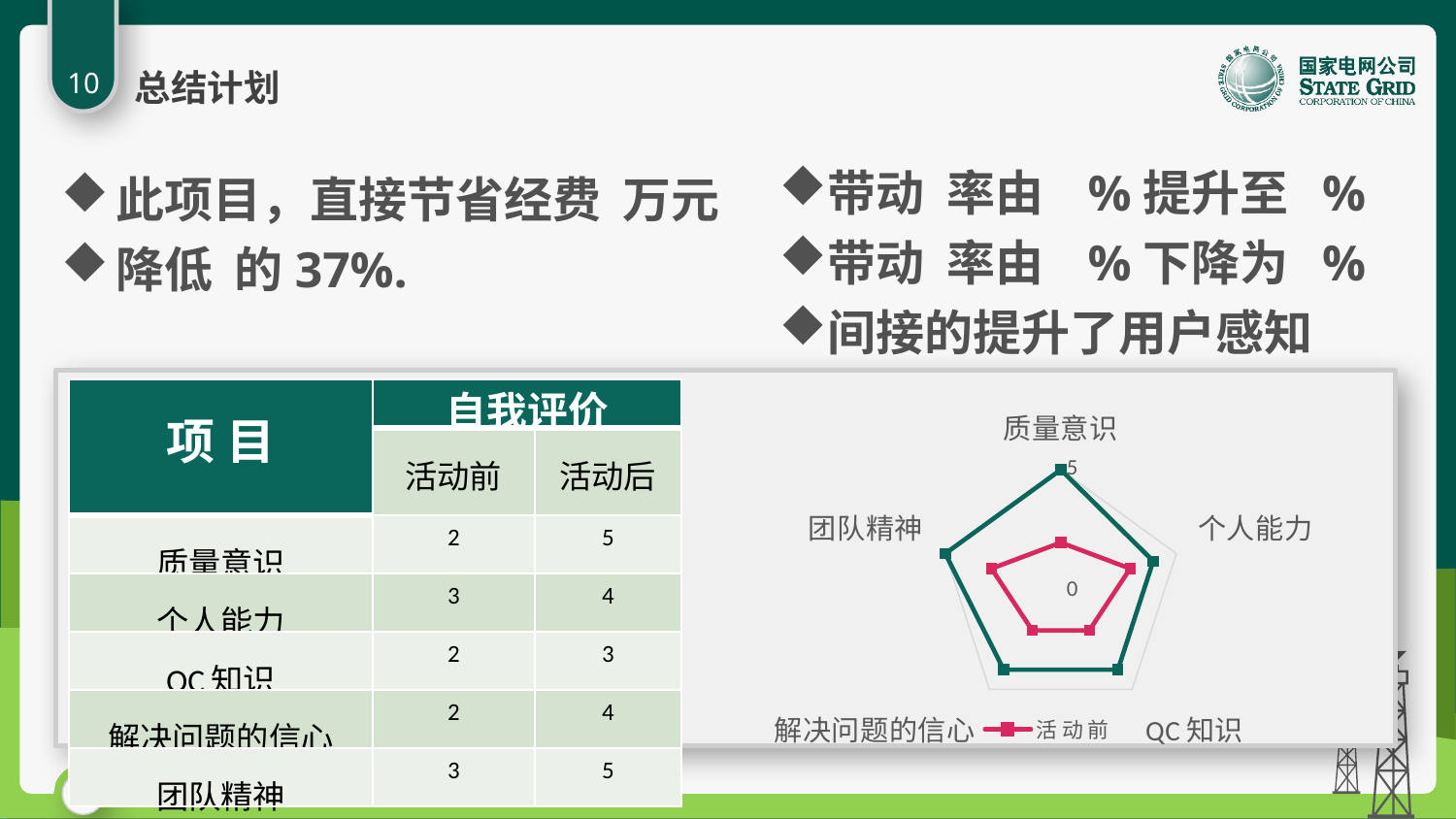
On the radar chart, which series has the larger value for 质量意识, 活动前 or 活动后? 活动后 On the radar chart, which series has the larger value for 团队精神, 活动前 or 活动后? 活动后 What is the maximum value shown on the radar chart's axis? 5 How many categories (axes) does the radar chart have? 5 On the radar chart, which series is drawn in red/pink? 活动前 On the radar chart, which series has the larger value for 个人能力, 活动前 or 活动后? 活动后 On the radar chart, what is the 活动后 value for 质量意识? 5 What kind of chart is shown on the right side of the slide? radar chart Which category is at the top of the radar chart? 质量意识